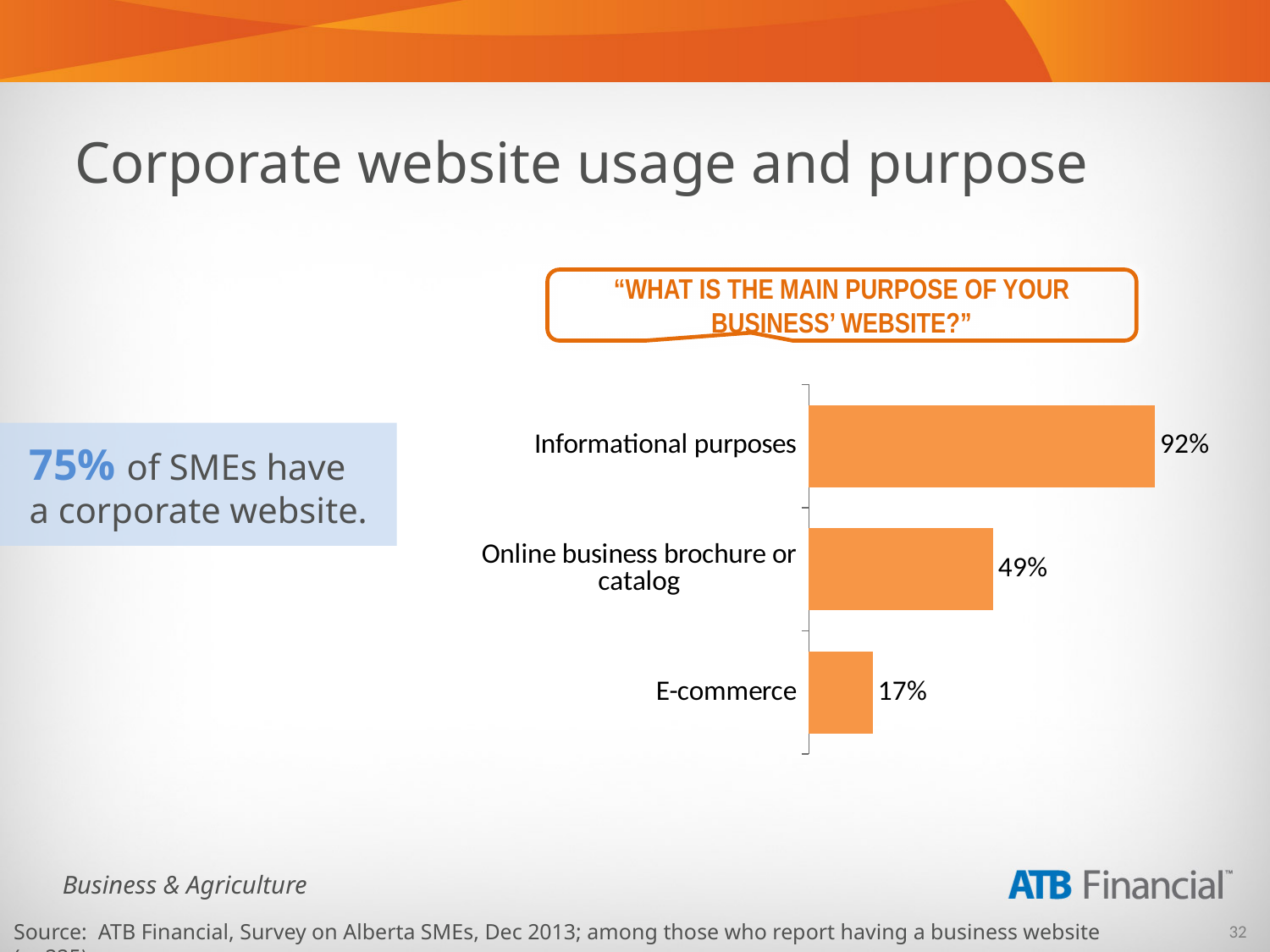
What is the value for E-commerce? 17% Which category has the lowest value? E-commerce Which category has the highest value? Informational purposes What kind of chart is shown on the slide? Bar chart What is the value for Online business brochure or catalog? 49% What colour are the bars in the chart? Orange What percentage of respondents use their website for informational purposes? 92% What is the difference between Informational purposes and E-commerce? 75 percentage points What survey question does the chart answer? "What is the main purpose of your business' website?" Which is larger, Online business brochure or catalog or E-commerce? Online business brochure or catalog What is the difference between Informational purposes and Online business brochure or catalog? 43 percentage points How many categories are shown in the chart? 3